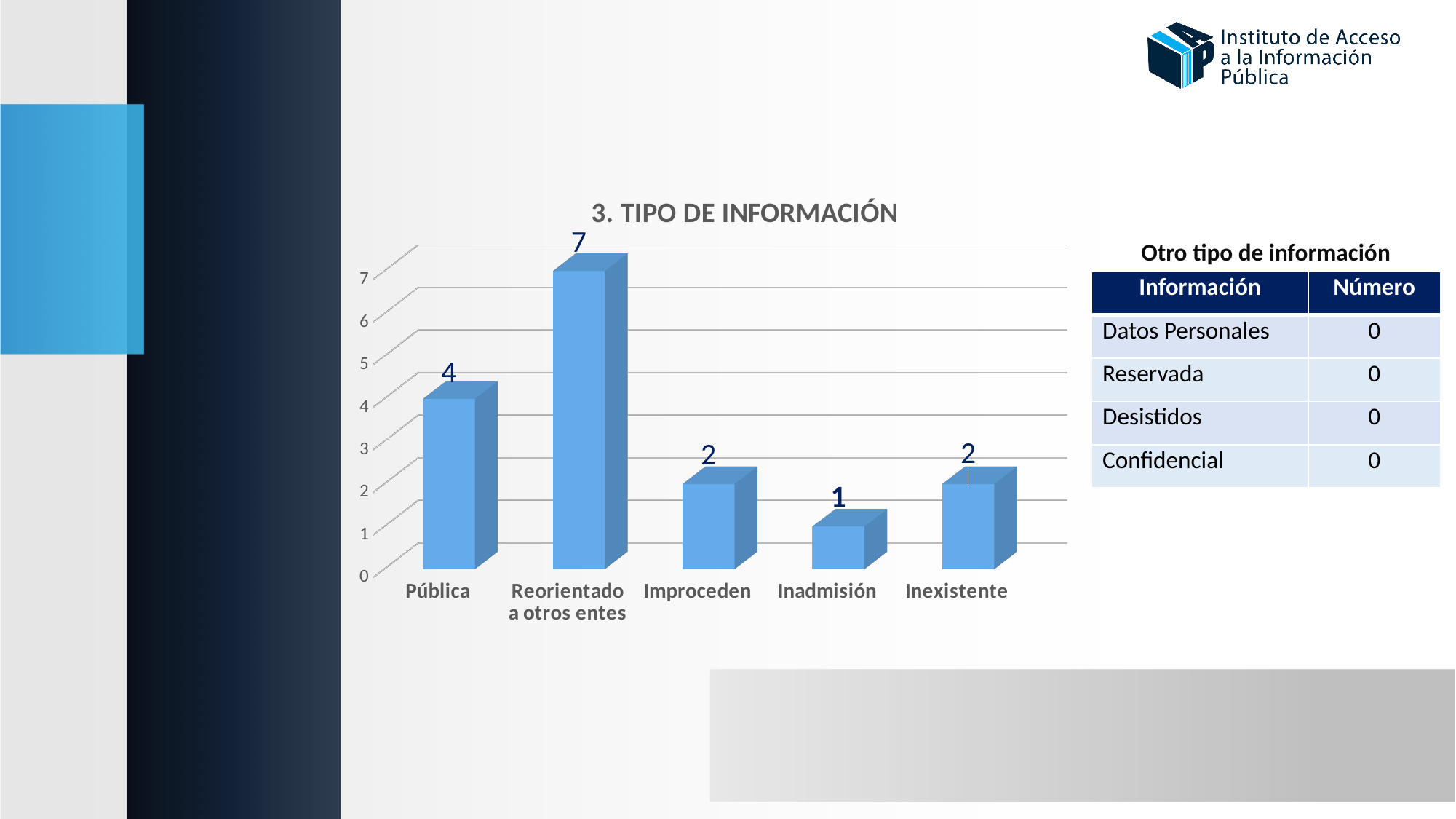
What is the value for Inexistente? 2 What kind of chart is this? bar chart Which category has the highest value? Reorientado a otros entes Which category has the lowest value? Inadmisión What is the value for Reorientado a otros entes? 7 What is the value for Inadmisión? 1 Is the value for Reorientado a otros entes greater or less than 5? greater Which is larger, the value for Pública or the value for Improceden? Pública What is the value for Pública? 4 How many categories are shown on the x axis? 5 What is the title of the chart? 3. TIPO DE INFORMACIÓN What is the difference between the values for Reorientado a otros entes and Pública? 3